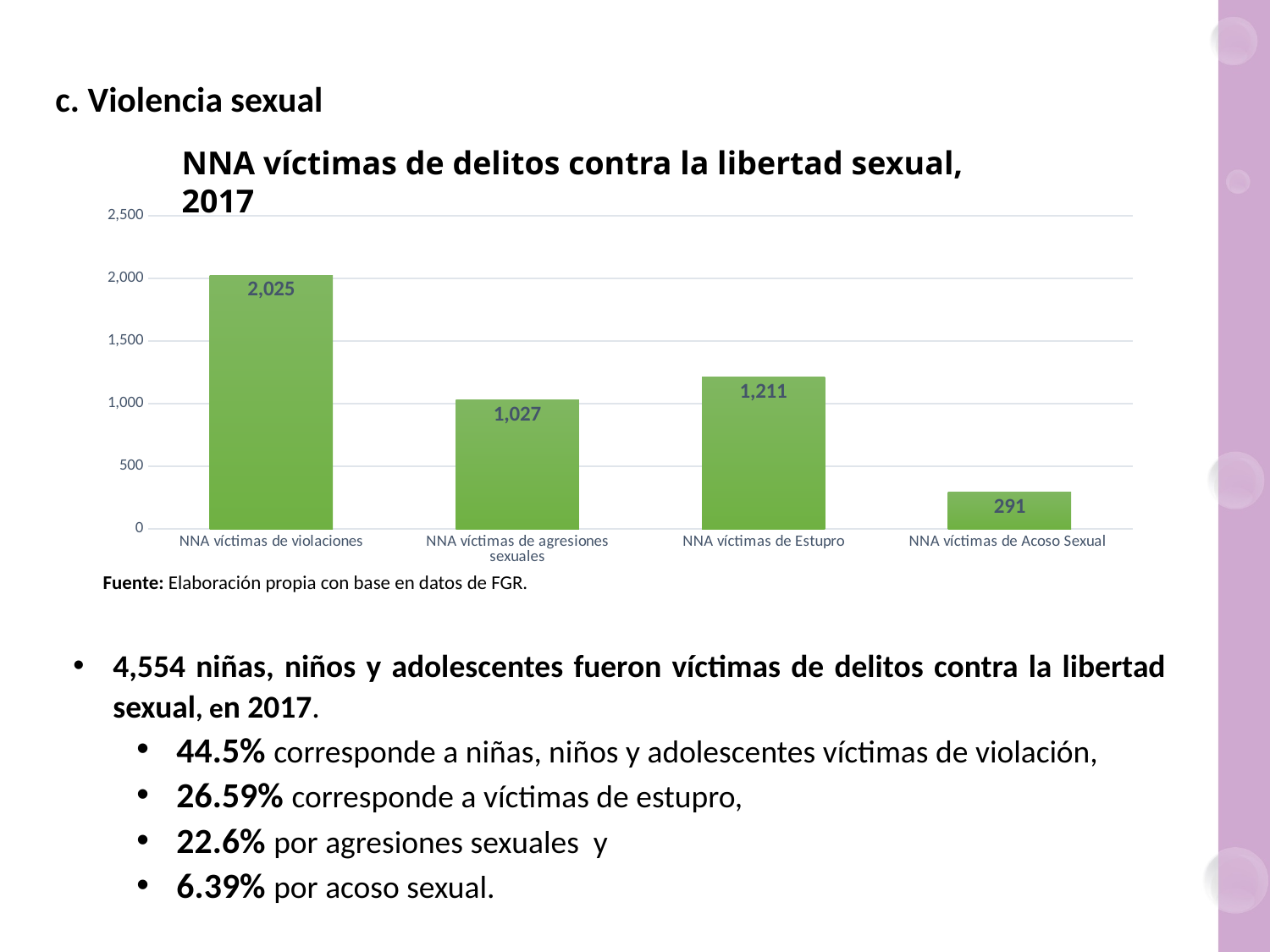
What is the value for NNA víctimas de agresiones sexuales? 1,027 Which category has the lowest value? NNA víctimas de Acoso Sexual How many categories are shown in the chart? 4 What kind of chart is shown on the slide? bar chart What is the value for NNA víctimas de Estupro? 1,211 Which is larger, the value for NNA víctimas de Estupro or NNA víctimas de agresiones sexuales? NNA víctimas de Estupro Is the value for NNA víctimas de Acoso Sexual greater or less than 500? less What is the title of the chart? NNA víctimas de delitos contra la libertad sexual, 2017 What is the value for NNA víctimas de Acoso Sexual? 291 Which category has the highest value? NNA víctimas de violaciones What is the value for NNA víctimas de violaciones? 2,025 What is the difference between the values for NNA víctimas de violaciones and NNA víctimas de Estupro? 814